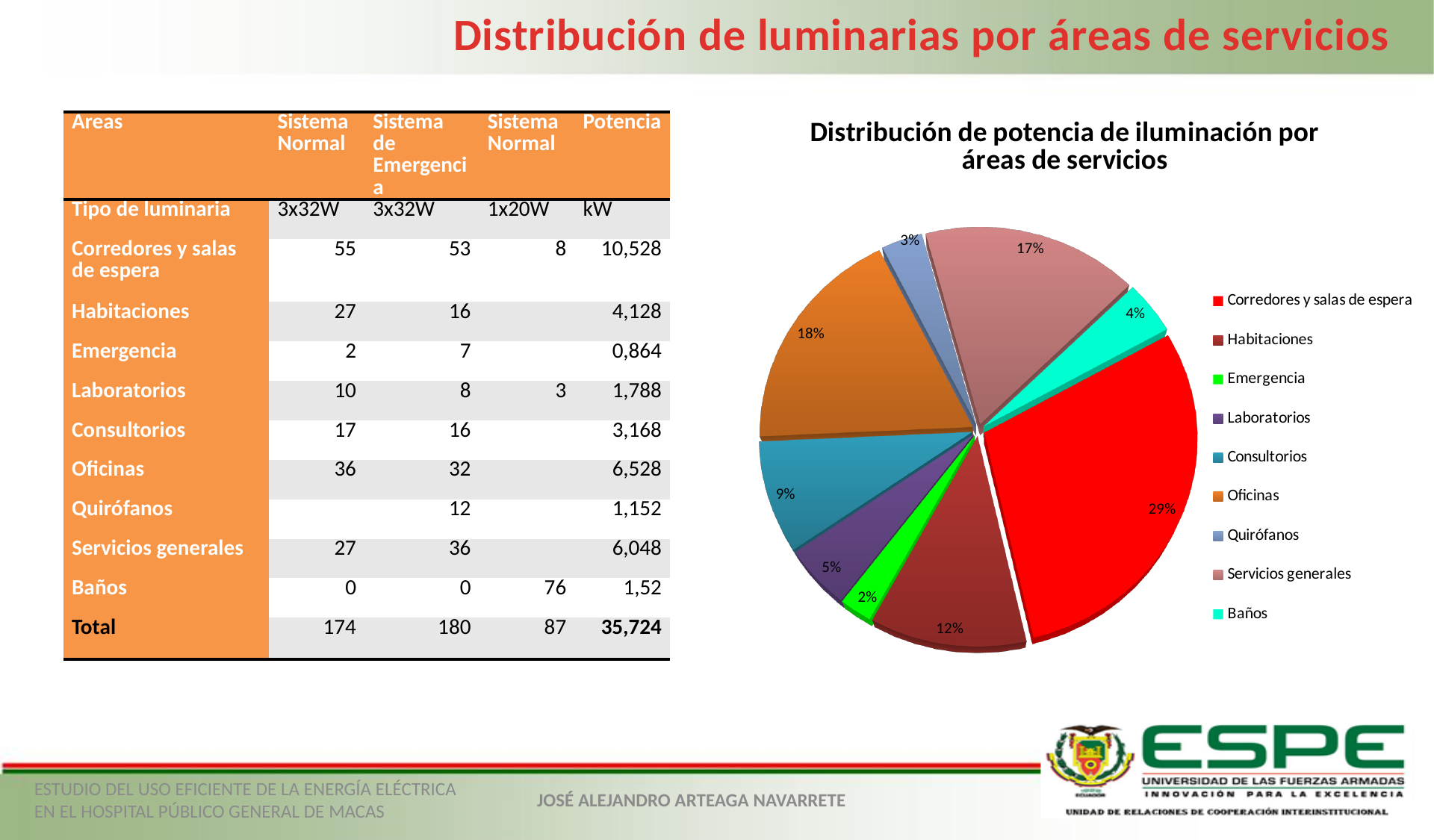
Which category has the smallest slice of the pie? Emergencia What share of the pie does Emergencia have? 2% Which category has the largest slice of the pie? Corredores y salas de espera What is the title of the chart? Distribución de potencia de iluminación por áreas de servicios What kind of chart is shown on the slide? pie chart What share of the pie does Corredores y salas de espera have? 29% Which has a larger share of the pie, Consultorios or Laboratorios? Consultorios What is the difference in percentage points between the Oficinas slice and the Quirófanos slice? 15 What share of the pie does Habitaciones have? 12% How many categories does the chart's legend list? 9